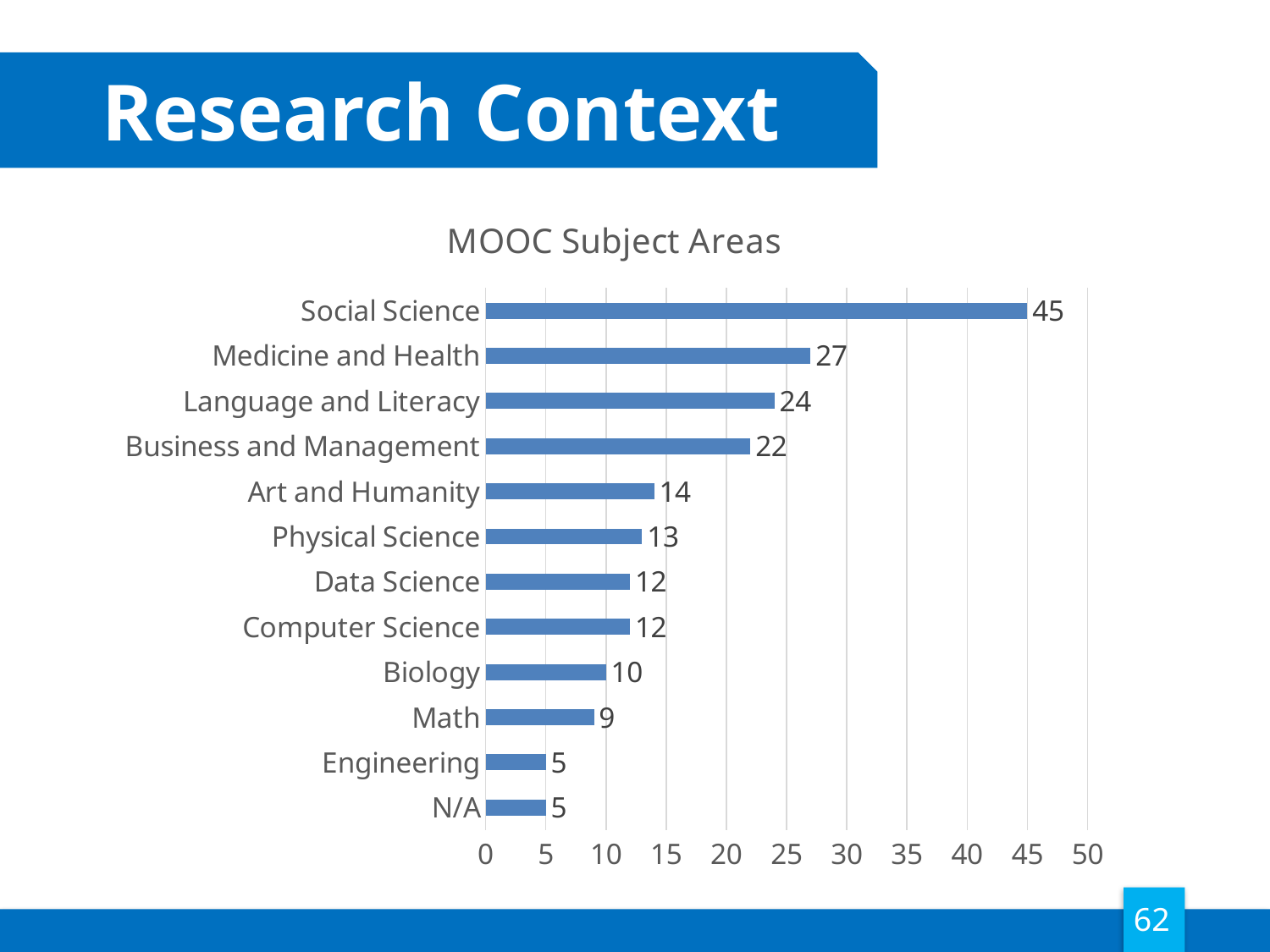
How many subject areas are shown in the chart? 12 What is the difference between the values for Social Science and Medicine and Health? 18 What is the value for Business and Management? 22 Which subject area has the highest value? Social Science Is the value for Medicine and Health greater or less than 25? greater What kind of chart is shown on the slide? Bar chart What is the value for Engineering? 5 What is the title of the chart? MOOC Subject Areas What is the difference between the values for Language and Literacy and Art and Humanity? 10 What is the value for Math? 9 What is the value for Social Science? 45 Which is larger, the value for Physical Science or the value for Biology? Physical Science